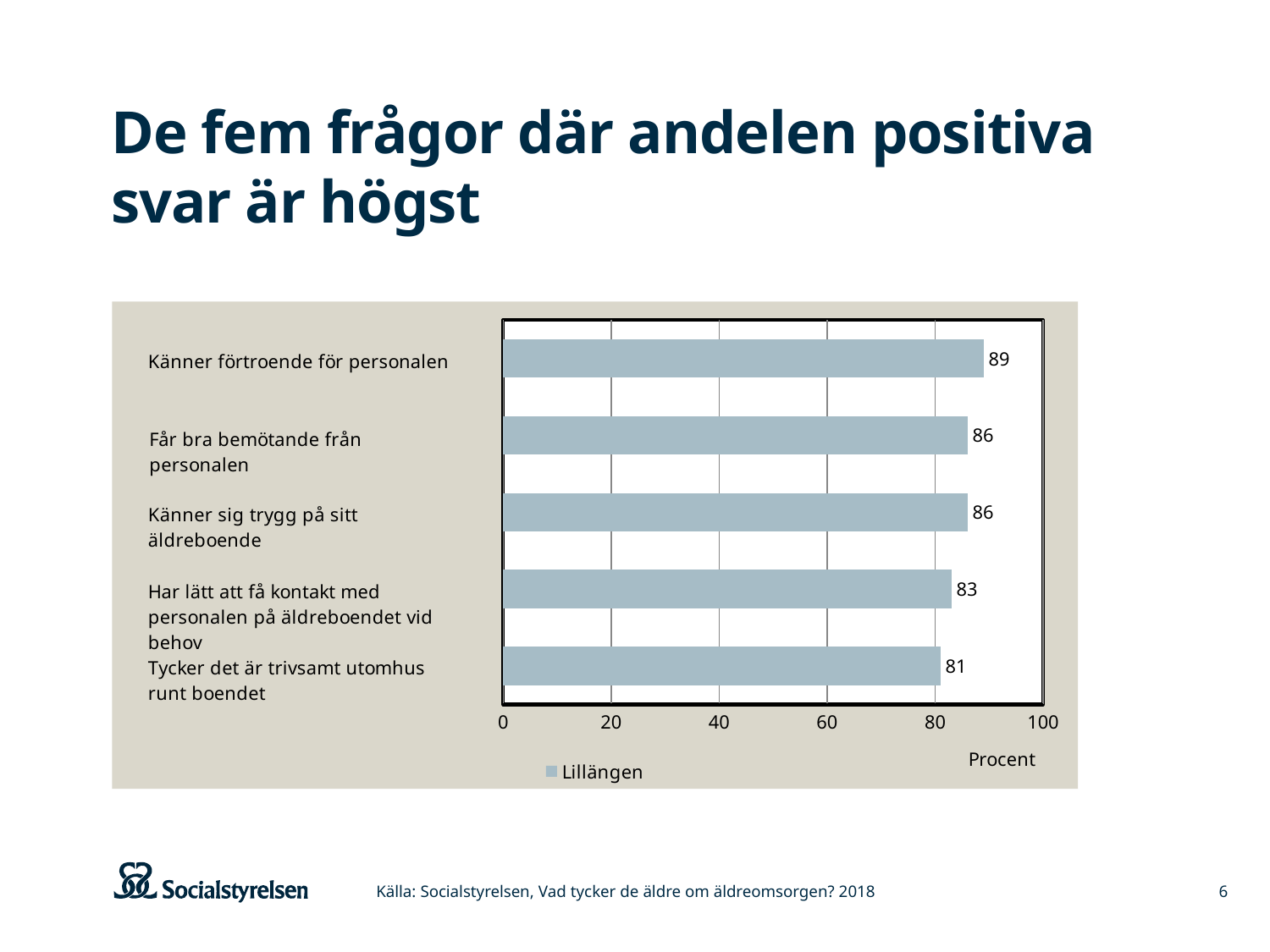
Which is larger: the value for "Får bra bemötande från personalen" or the value for "Har lätt att få kontakt med personalen på äldreboendet vid behov"? Får bra bemötande från personalen What is the value for "Känner förtroende för personalen"? 89 Is the value for "Känner sig trygg på sitt äldreboende" greater or less than 80? greater What kind of chart is shown on the slide? bar chart Which category has the lowest value? Tycker det är trivsamt utomhus runt boendet Which category has the highest value? Känner förtroende för personalen How many categories are shown in the chart? 5 What is the value for "Tycker det är trivsamt utomhus runt boendet"? 81 How many series does the legend list? 1 What is the difference between the values for "Känner förtroende för personalen" and "Tycker det är trivsamt utomhus runt boendet"? 8 What series name is shown in the legend? Lillängen What is the value for "Har lätt att få kontakt med personalen på äldreboendet vid behov"? 83